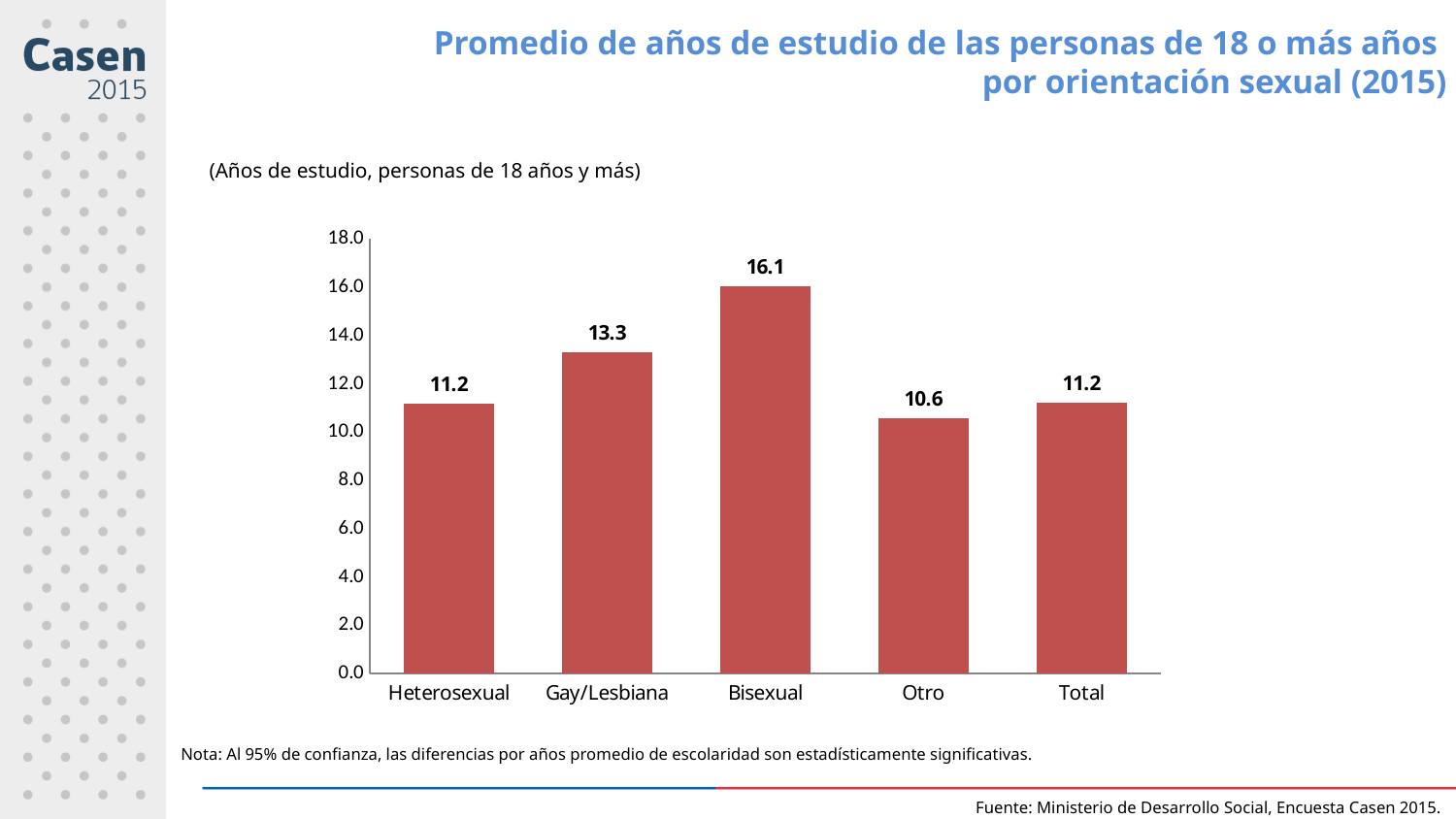
What is the difference between the values for Bisexual and Heterosexual? 4.9 Which category has the lowest average years of schooling? Otro Which is larger, the value for Gay/Lesbiana or the value for Heterosexual? Gay/Lesbiana How many categories are shown on the x axis? 5 What is the value shown for Otro? 10.6 Which category has the highest average years of schooling? Bisexual What kind of chart is shown on the slide? Bar chart What is the value shown for Total? 11.2 What is the difference between the values for Gay/Lesbiana and Otro? 2.7 What is the average years of schooling for Bisexual? 16.1 What is the average years of schooling for Gay/Lesbiana? 13.3 What is the maximum value shown on the y axis? 18.0